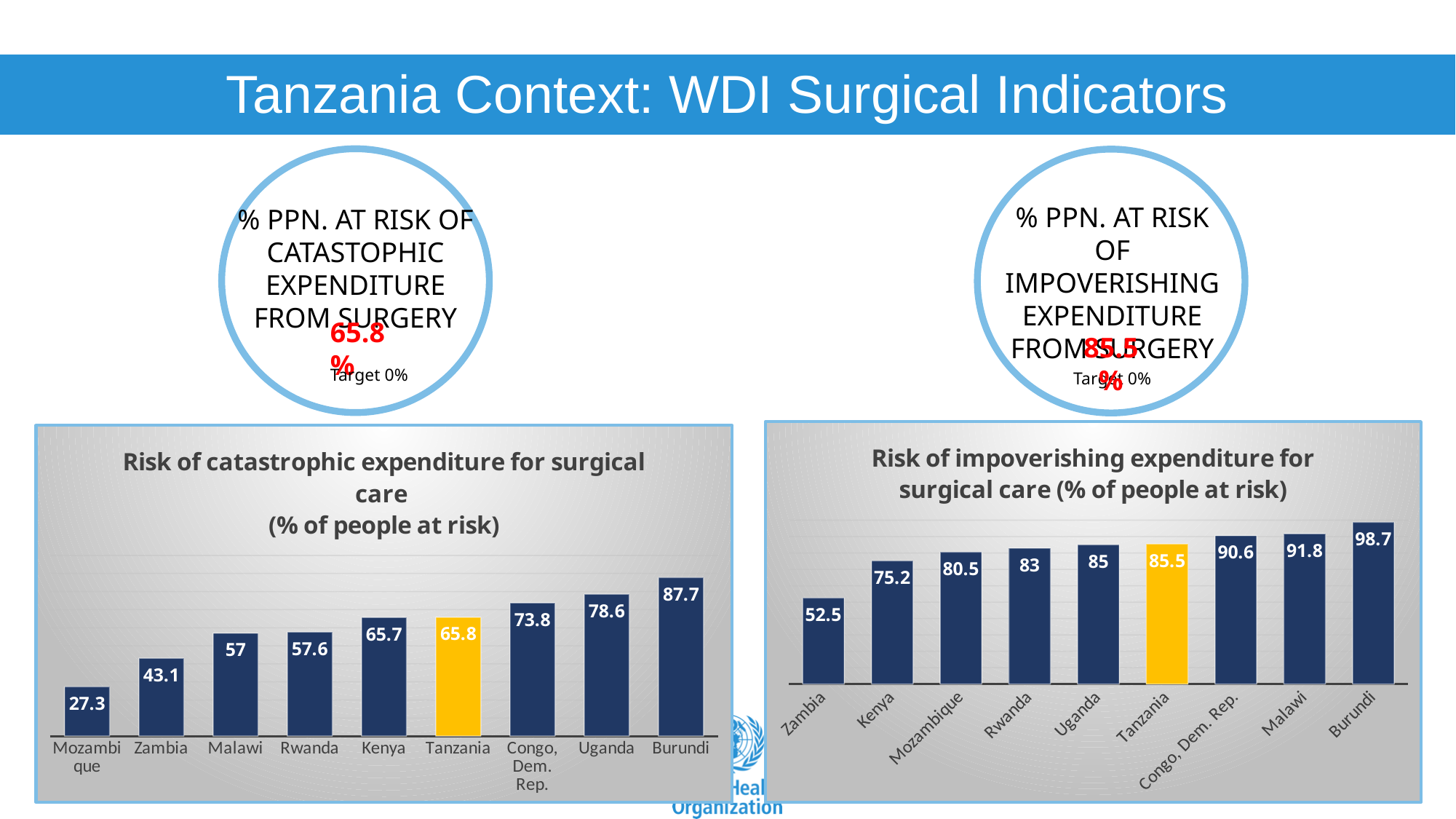
In the 'Risk of catastrophic expenditure for surgical care' chart, which country has the lowest value? Mozambique In the 'Risk of impoverishing expenditure for surgical care' chart, what is the value for Kenya? 75.2 In the 'Risk of impoverishing expenditure for surgical care' chart, which country has the lowest value? Zambia In the 'Risk of catastrophic expenditure for surgical care' chart, what is the difference between Uganda and Zambia? 35.5 In the 'Risk of catastrophic expenditure for surgical care' chart, which country's bar is highlighted in yellow? Tanzania In the 'Risk of catastrophic expenditure for surgical care' chart, what is the value for Tanzania? 65.8 In the 'Risk of impoverishing expenditure for surgical care' chart, do the values rise or fall from left to right? Rise In the 'Risk of catastrophic expenditure for surgical care' chart, which country has the highest value? Burundi In the 'Risk of impoverishing expenditure for surgical care' chart, what is the difference between Burundi and Tanzania? 13.2 What type of chart is the 'Risk of catastrophic expenditure for surgical care' chart? Bar chart In the 'Risk of catastrophic expenditure for surgical care' chart, which is larger, the value for Kenya or the value for Malawi? Kenya How many countries are shown in the 'Risk of impoverishing expenditure for surgical care' chart? 9